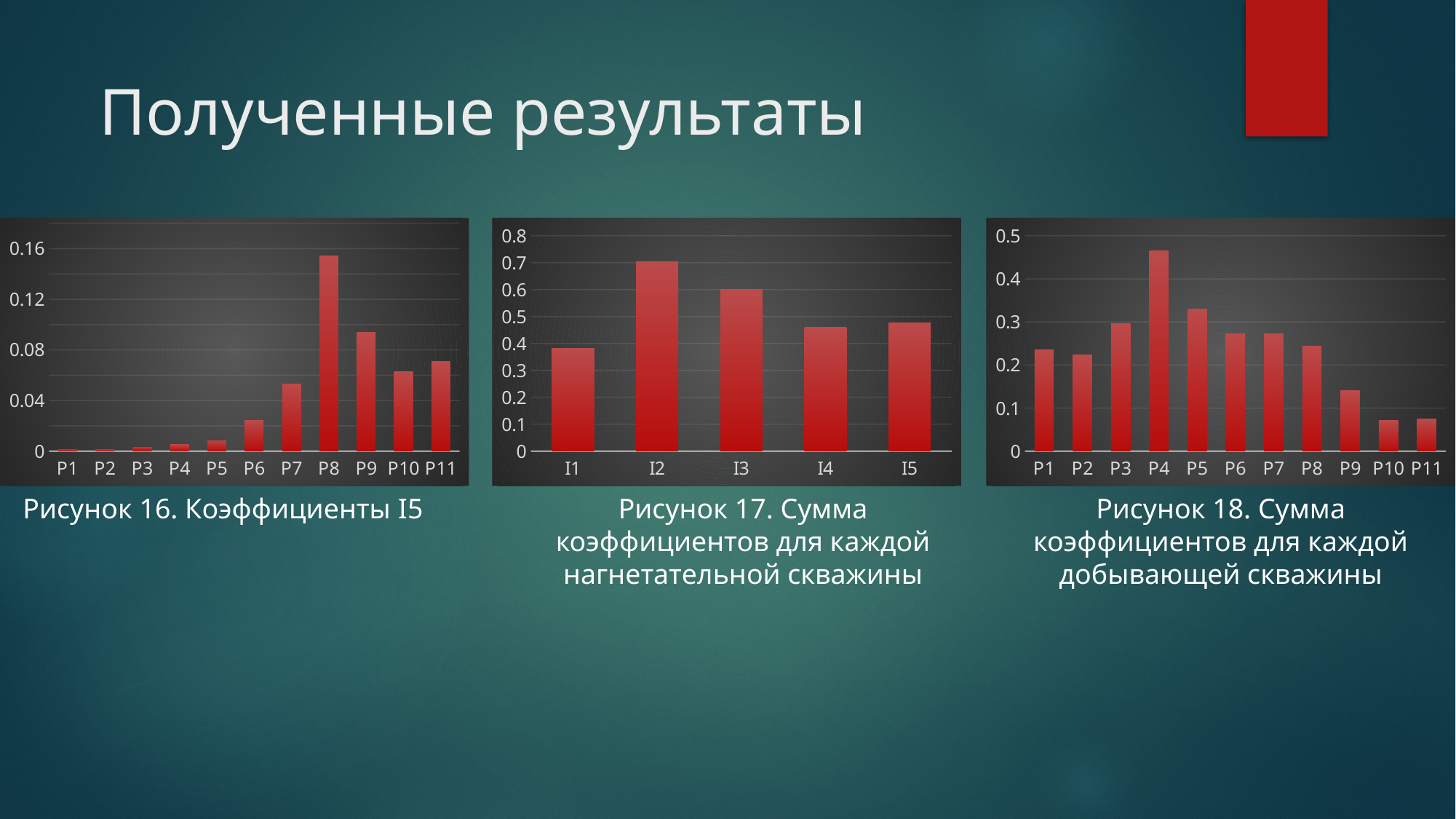
In the chart titled 'Рисунок 16. Коэффициенты I5', how many categories are shown on the x axis? 11 In the chart titled 'Рисунок 17. Сумма коэффициентов для каждой нагнетательной скважины', which category has the lowest value? I1 In the chart titled 'Рисунок 16. Коэффициенты I5', which is larger, the value for P7 or the value for P10? P10 In the chart titled 'Рисунок 18. Сумма коэффициентов для каждой добывающей скважины', which category has the highest value? P4 In the chart titled 'Рисунок 16. Коэффициенты I5', is the value for P9 greater or less than 0.08? greater In the chart titled 'Рисунок 18. Сумма коэффициентов для каждой добывающей скважины', is the value for P9 greater or less than 0.1? greater What type of chart is 'Рисунок 18. Сумма коэффициентов для каждой добывающей скважины'? bar chart In the chart titled 'Рисунок 16. Коэффициенты I5', is the value for P6 greater or less than 0.04? less In the chart titled 'Рисунок 17. Сумма коэффициентов для каждой нагнетательной скважины', how many categories are shown? 5 In the chart titled 'Рисунок 17. Сумма коэффициентов для каждой нагнетательной скважины', which category has the highest value? I2 In the chart titled 'Рисунок 16. Коэффициенты I5', which category has the highest value? P8